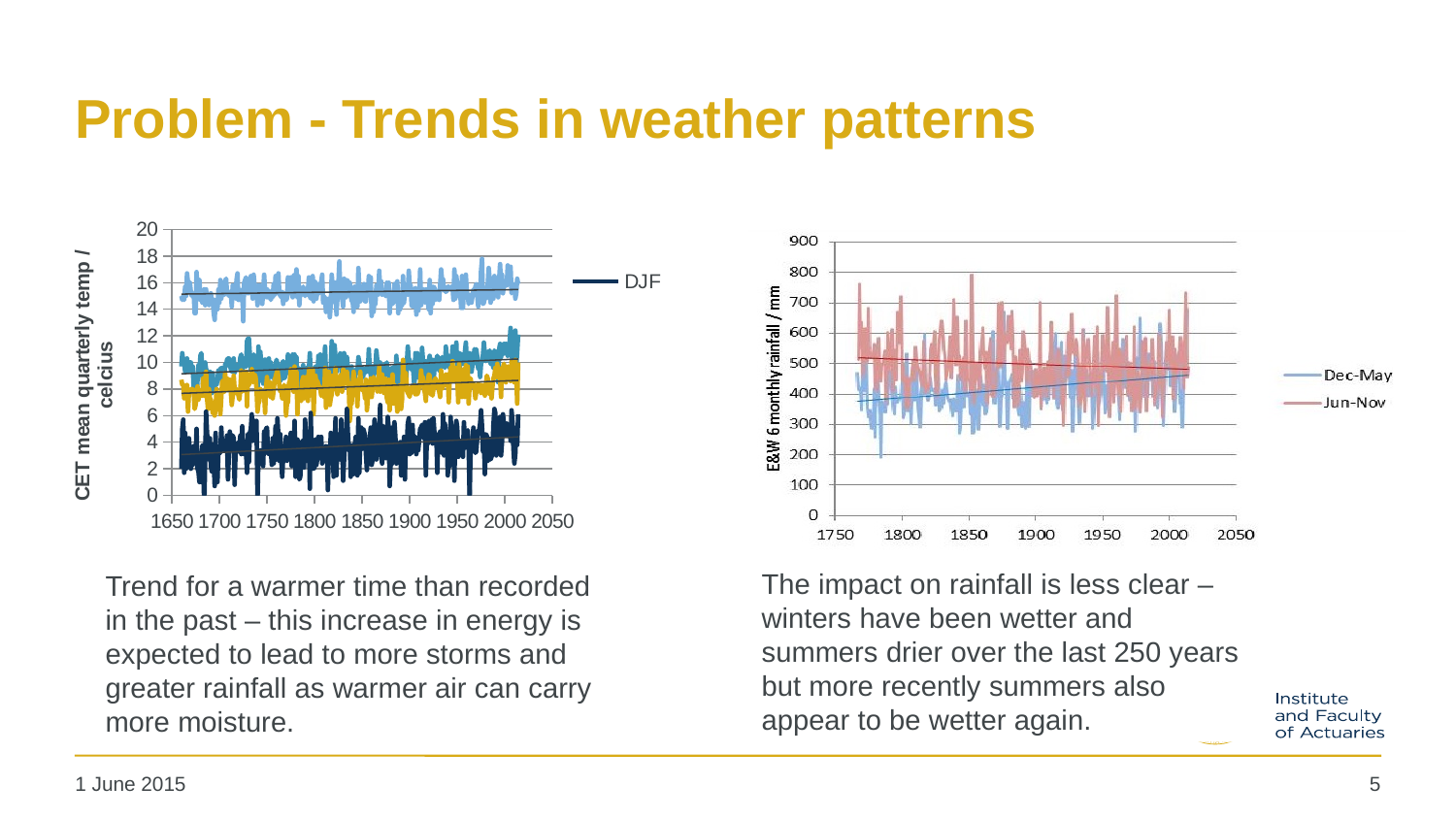
In the right chart (E&W 6 monthly rainfall), is the Jun-Nov trend line around 1800 greater or less than 400? greater In the right chart (E&W 6 monthly rainfall), which series is higher around 1800, Dec-May or Jun-Nov? Jun-Nov What kind of chart is the left chart (CET mean quarterly temp)? line chart What kind of chart is the right chart (E&W 6 monthly rainfall)? line chart How many series does the legend of the left chart (CET mean quarterly temp) list? 1 In the right chart (E&W 6 monthly rainfall), what are the two series named in the legend? Dec-May and Jun-Nov In the left chart (CET mean quarterly temp), is the DJF series generally greater or less than 8? less How many series does the legend of the right chart (E&W 6 monthly rainfall) list? 2 In the left chart (CET mean quarterly temp), what is the series named in the legend? DJF In the right chart (E&W 6 monthly rainfall), does the Jun-Nov trend line rise or fall from 1750 to 2000? fall In the left chart (CET mean quarterly temp), is the DJF series the highest or the lowest of the plotted series? lowest In the right chart (E&W 6 monthly rainfall), does the Dec-May trend line rise or fall from 1750 to 2000? rise